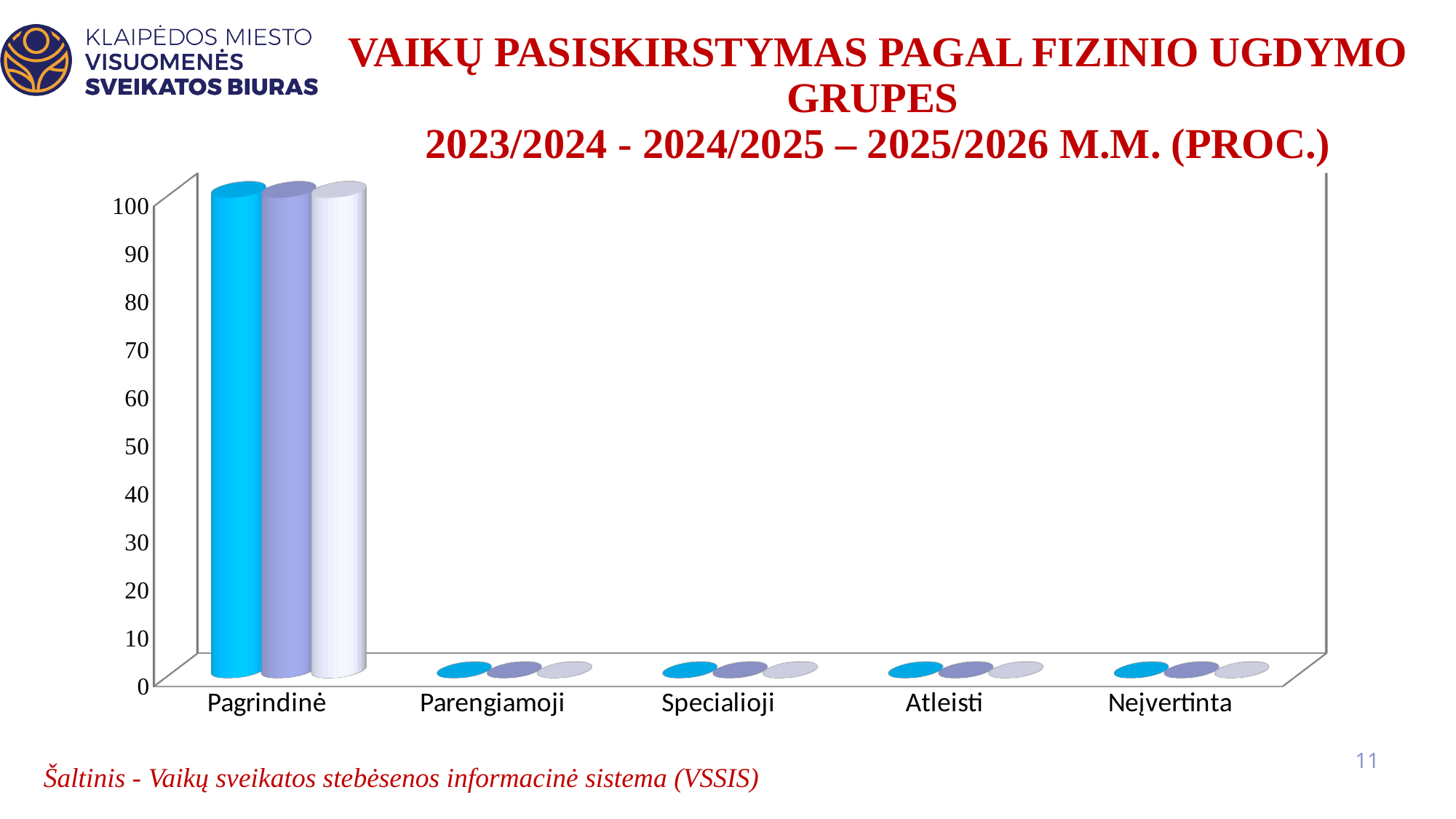
Which category has larger values, Atleisti or Pagrindinė? Pagrindinė What is the highest tick value shown on the vertical axis of the chart? 100 Which category has the highest values in the chart? Pagrindinė Are the values for Neįvertinta greater or less than 10? less Are the values for Atleisti greater or less than 20? less What is the label of the last category on the x axis of the chart? Neįvertinta Are the values for Pagrindinė greater or less than 90? greater What kind of chart is shown on the slide? bar chart Which category has larger values, Pagrindinė or Specialioji? Pagrindinė How many categories are shown on the x axis of the chart? 5